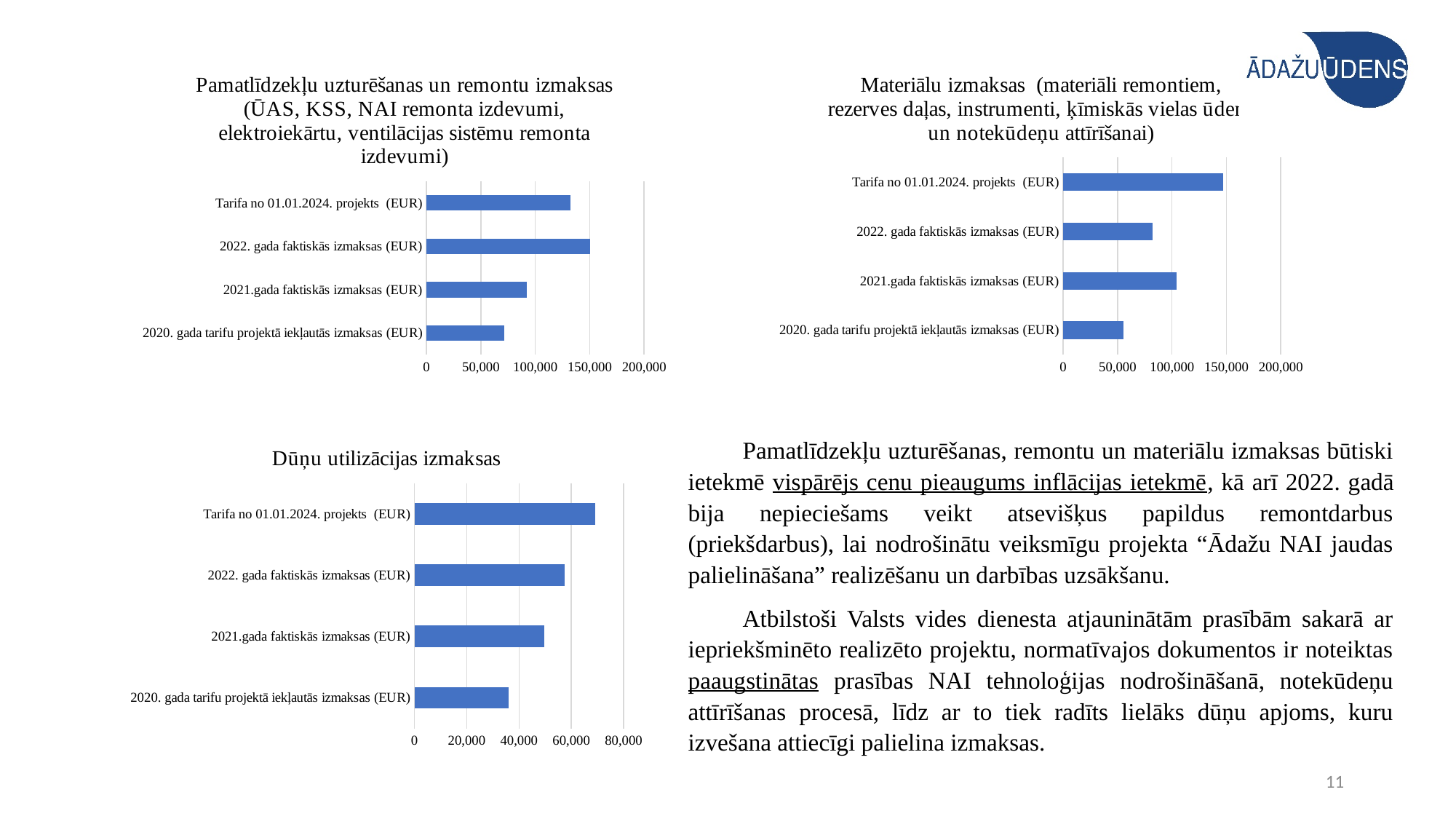
In the chart titled "Materiālu izmaksas", which is larger: the value for 2021.gada faktiskās izmaksas (EUR) or for 2022. gada faktiskās izmaksas (EUR)? 2021.gada faktiskās izmaksas (EUR) How many categories are shown in the chart titled "Dūņu utilizācijas izmaksas"? 4 In the chart titled "Dūņu utilizācijas izmaksas", is the value for Tarifa no 01.01.2024. projekts (EUR) greater or less than 60,000? greater In the chart titled "Pamatlīdzekļu uzturēšanas un remontu izmaksas", which category has the highest value? 2022. gada faktiskās izmaksas (EUR) What type of chart is the chart titled "Pamatlīdzekļu uzturēšanas un remontu izmaksas"? bar chart In the chart titled "Pamatlīdzekļu uzturēšanas un remontu izmaksas", which category has the lowest value? 2020. gada tarifu projektā iekļautās izmaksas (EUR) In the chart titled "Materiālu izmaksas", is the value for 2022. gada faktiskās izmaksas (EUR) greater or less than 100,000? less In the chart titled "Materiālu izmaksas", which category has the lowest value? 2020. gada tarifu projektā iekļautās izmaksas (EUR) In the chart titled "Dūņu utilizācijas izmaksas", is the value for 2021.gada faktiskās izmaksas (EUR) greater or less than 60,000? less In the chart titled "Dūņu utilizācijas izmaksas", which category has the highest value? Tarifa no 01.01.2024. projekts (EUR) In the chart titled "Materiālu izmaksas", which category has the highest value? Tarifa no 01.01.2024. projekts (EUR)